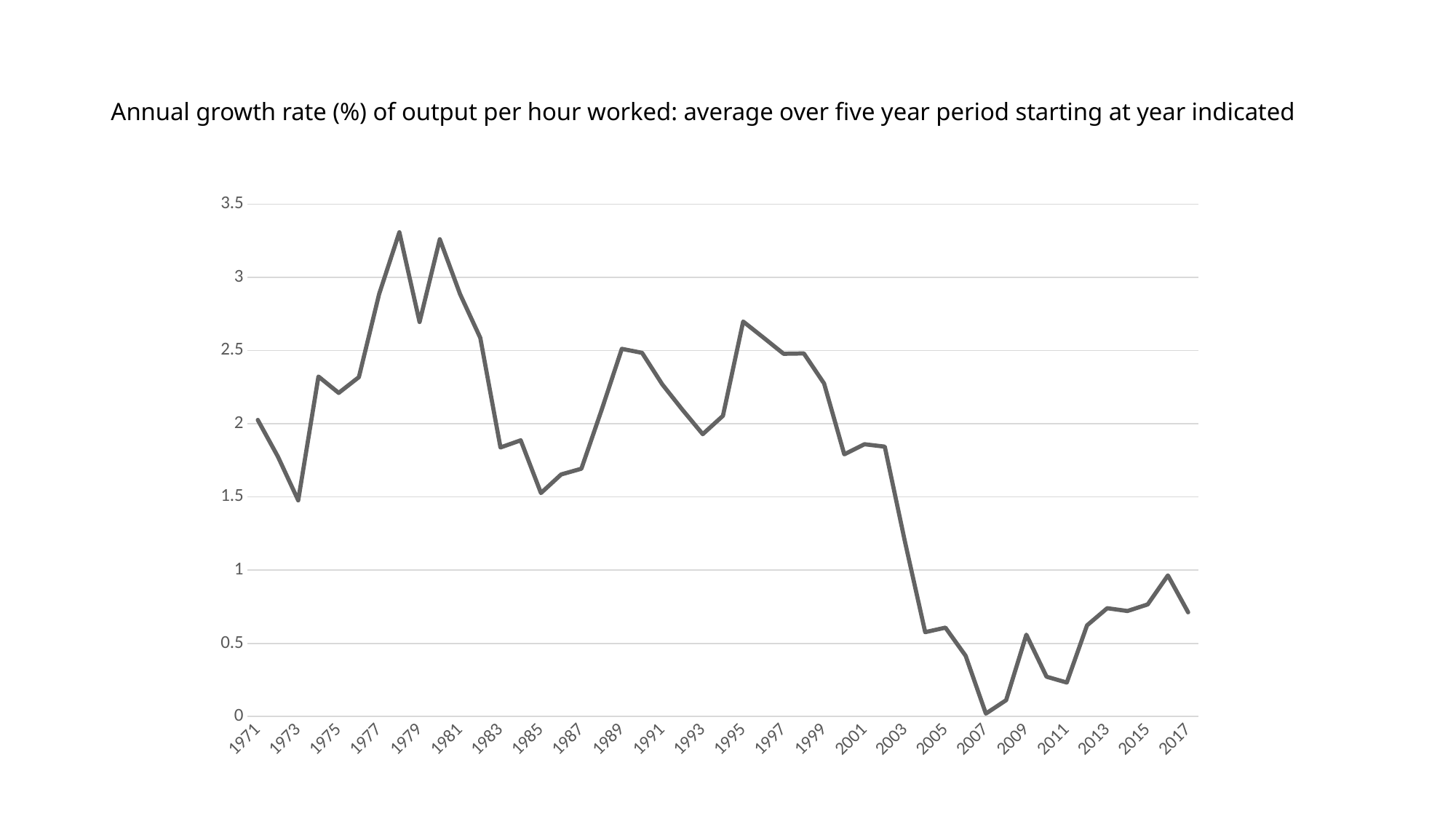
Which is larger, the value for 1978 or the value for 2007? 1978 Is the value for 2007 greater or less than 0.5? less Overall, does the line rise or fall from 1971 to 2017? fall Is the value for 2011 greater or less than 0.5? less What is the title of the chart? Annual growth rate (%) of output per hour worked: average over five year period starting at year indicated Which is larger, the value for 1971 or the value for 2017? 1971 Is the value for 2003 greater or less than 1.5? less Which year has the lowest value on the chart? 2007 What kind of chart is shown on the slide? line chart